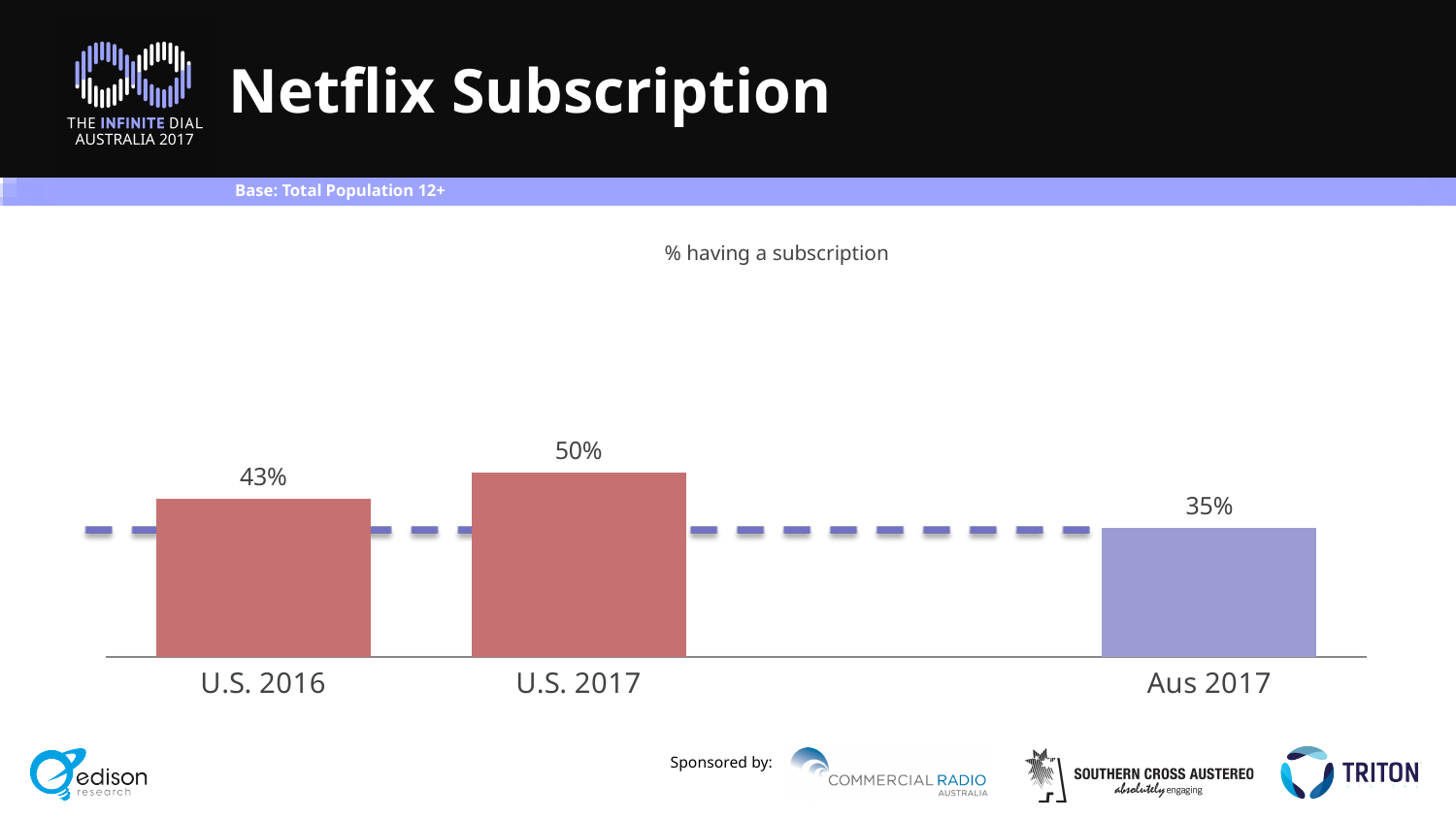
Which category has the highest value? U.S. 2017 What is the difference between the U.S. 2017 and U.S. 2016 values? 7% Did the U.S. value rise or fall from 2016 to 2017? Rise What kind of chart is shown on the slide? Bar chart What is the title of the slide? Netflix Subscription What is the value shown for U.S. 2017? 50% What percentage of the U.S. population had a Netflix subscription in 2016? 43% Which is larger, the value for U.S. 2016 or Aus 2017? U.S. 2016 What is the difference between the U.S. 2017 and Aus 2017 values? 15% What is the value shown for Aus 2017? 35% How many categories are shown in the chart? 3 Which category has the lowest value? Aus 2017